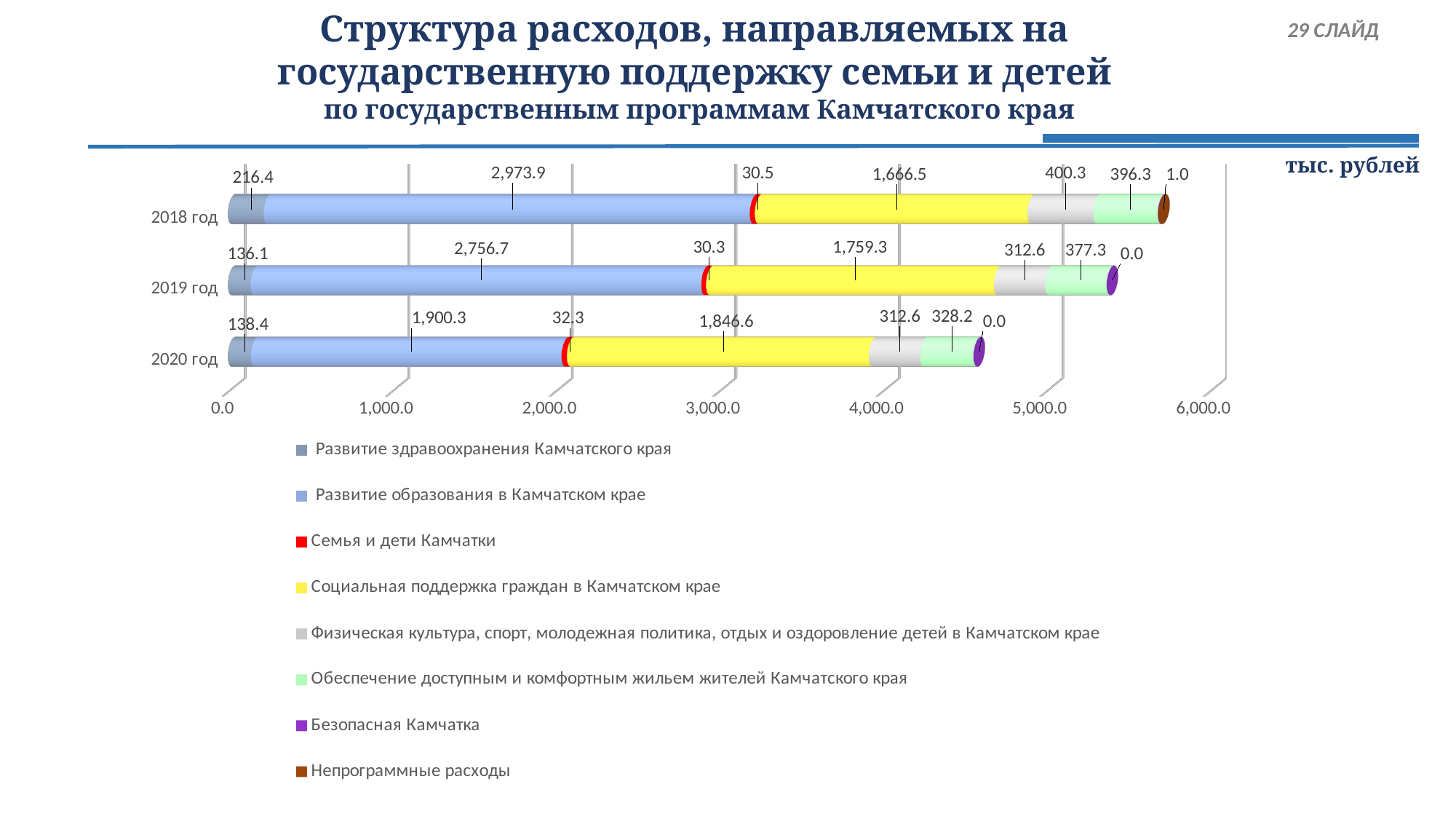
Does the value for Социальная поддержка граждан в Камчатском крае rise or fall from 2018 год to 2020 год? rises Is the total length of the 2020 год bar greater or less than 5,000.0? less What is the value for Развитие образования в Камчатском крае in 2018 год? 2,973.9 What is the value for Социальная поддержка граждан в Камчатском крае in 2020 год? 1,846.6 What is the value for Развитие здравоохранения Камчатского края in 2019 год? 136.1 What kind of chart is shown on the slide? bar chart What is the value for Непрограммные расходы in 2018 год? 1.0 Which year has the larger value for Семья и дети Камчатки: 2018 год or 2020 год? 2020 год How many years (categories) are plotted on the chart? 3 In which year is the value for Развитие образования в Камчатском крае the highest? 2018 год How many series does the legend list? 8 What is the difference between the Развитие образования в Камчатском крае values for 2019 год and 2020 год? 856.4